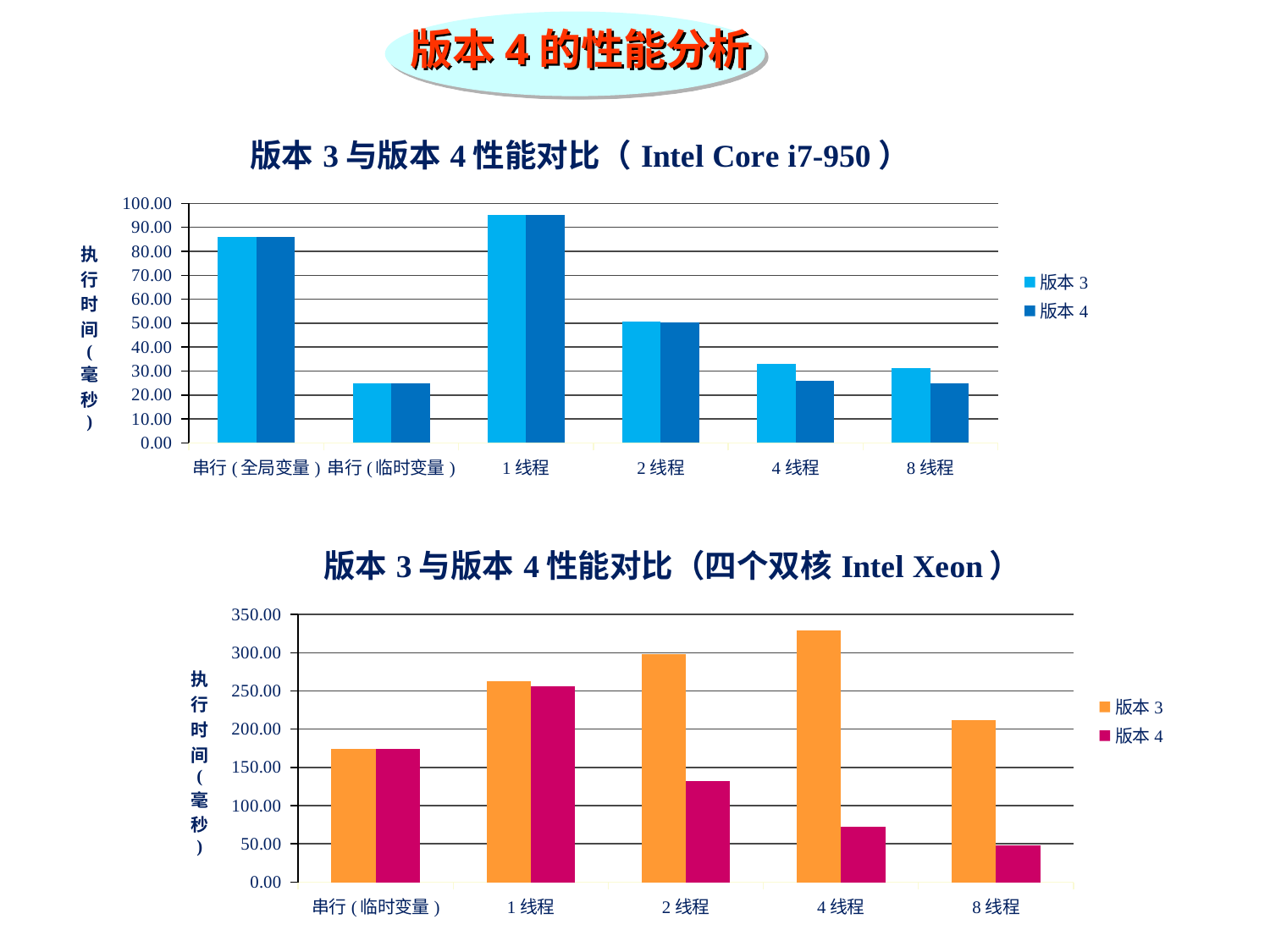
In the bottom chart (四个双核 Intel Xeon), which category has the lowest value for 版本 4? 8 线程 In the bottom chart (四个双核 Intel Xeon), which category has the highest value for 版本 3? 4 线程 In the top chart (Intel Core i7-950), which category has the highest value for 版本 3? 1 线程 In the top chart (Intel Core i7-950), is the value for 版本 4 at 4 线程 greater or less than 30.00? less What kind of chart is the top chart (Intel Core i7-950)? bar chart In the top chart (Intel Core i7-950), how many categories are shown on the x axis? 6 In the top chart (Intel Core i7-950), is the value for 版本 3 at 1 线程 greater or less than 90.00? greater In the bottom chart (四个双核 Intel Xeon), how many categories are shown on the x axis? 5 In the top chart (Intel Core i7-950), at 8 线程, which series has the larger value, 版本 3 or 版本 4? 版本 3 In the bottom chart (四个双核 Intel Xeon), is the value for 版本 3 at 2 线程 greater or less than 250.00? greater In the top chart (Intel Core i7-950), how many series does the legend list? 2 In the bottom chart (四个双核 Intel Xeon), do the 版本 4 values rise or fall from 1 线程 to 8 线程? fall